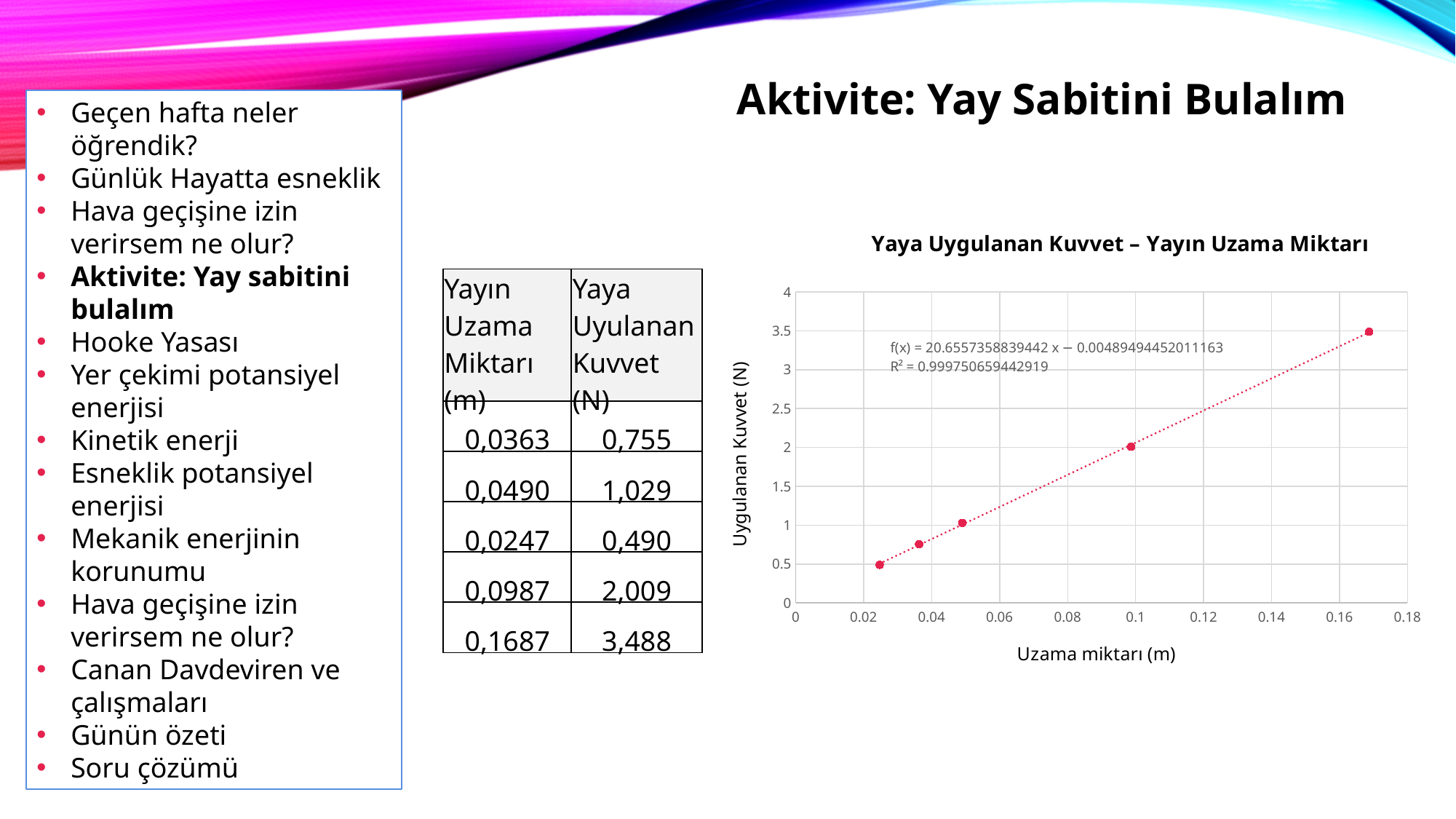
What is the slope (coefficient of x) in the trendline equation printed on the chart? 20.6557358839442 Is the applied force for the data point near 0.1 m extension greater or less than 1.5 N? greater Do the plotted values rise or fall as the extension (Uzama miktarı) increases along the x axis? rise What kind of chart is shown on the slide? scatter chart Is the applied force for the rightmost data point greater or less than 3 N? greater What is the label of the chart's y axis? Uygulanan Kuvvet (N) Which data point has the highest applied force: the leftmost or the rightmost? the rightmost Is the applied force for the leftmost data point greater or less than 1 N? less What R² value is printed on the chart for the trendline? 0.999750659442919 How many data points are plotted on the chart? 5 What is the title of the chart? Yaya Uygulanan Kuvvet – Yayın Uzama Miktarı